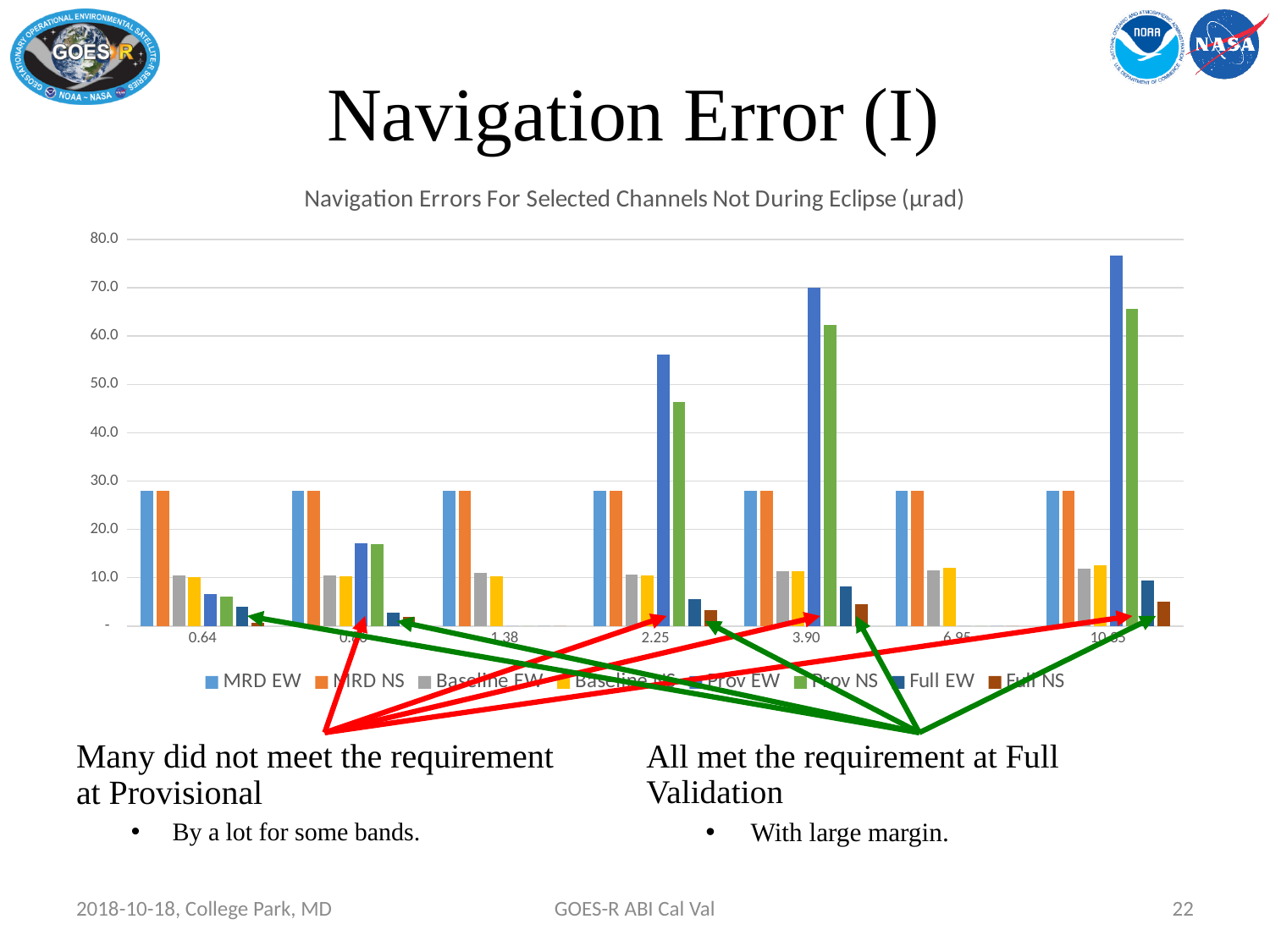
How many categories are shown along the x axis of the chart? 7 At 3.90, which is larger: Prov EW or Prov NS? Prov EW Is the value for Prov NS at 2.25 greater or less than 50? less Which series is listed first in the chart legend? MRD EW How many series does the chart legend list? 8 What is the title of the chart? Navigation Errors For Selected Channels Not During Eclipse (μrad) Which series has the tallest bar at 3.90? Prov EW What kind of chart is shown on the slide? bar chart Is the value for Prov EW at 3.90 greater or less than 60? greater Is the value for MRD EW at 0.64 greater or less than 30? less